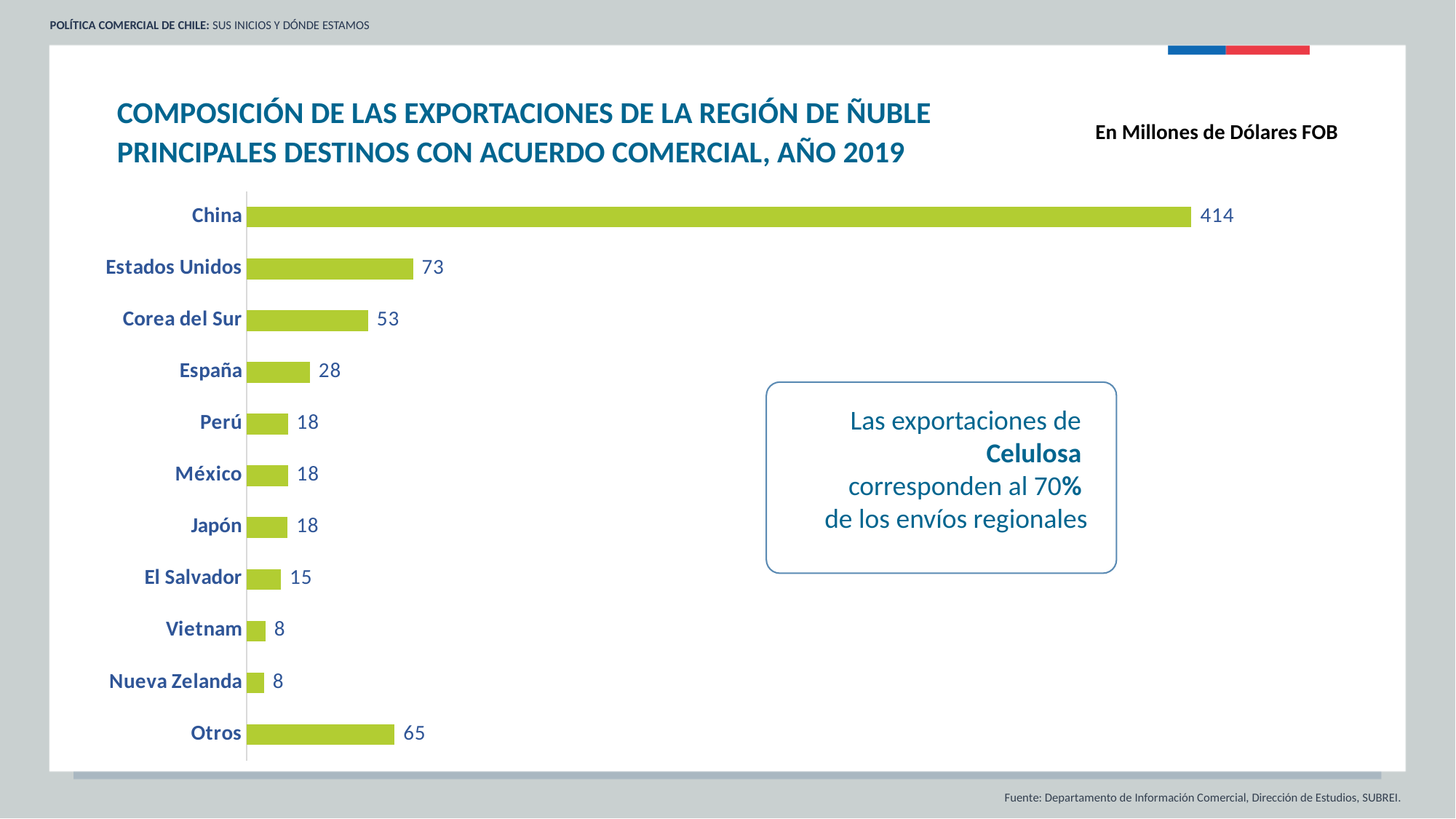
What is the value for Estados Unidos? 73 Which is larger, the value for Otros or the value for Estados Unidos? Estados Unidos What kind of chart is shown on the slide? Bar chart What is the value for Corea del Sur? 53 In what unit are the values expressed, according to the slide? Millones de Dólares FOB What is the value for El Salvador? 15 What is the value for China? 414 How many categories are shown in the chart? 11 Which destination has the highest value? China What is the difference between the values for China and Estados Unidos? 341 What is the difference between the values for Otros and Corea del Sur? 12 Which is larger, the value for España or the value for Perú? España